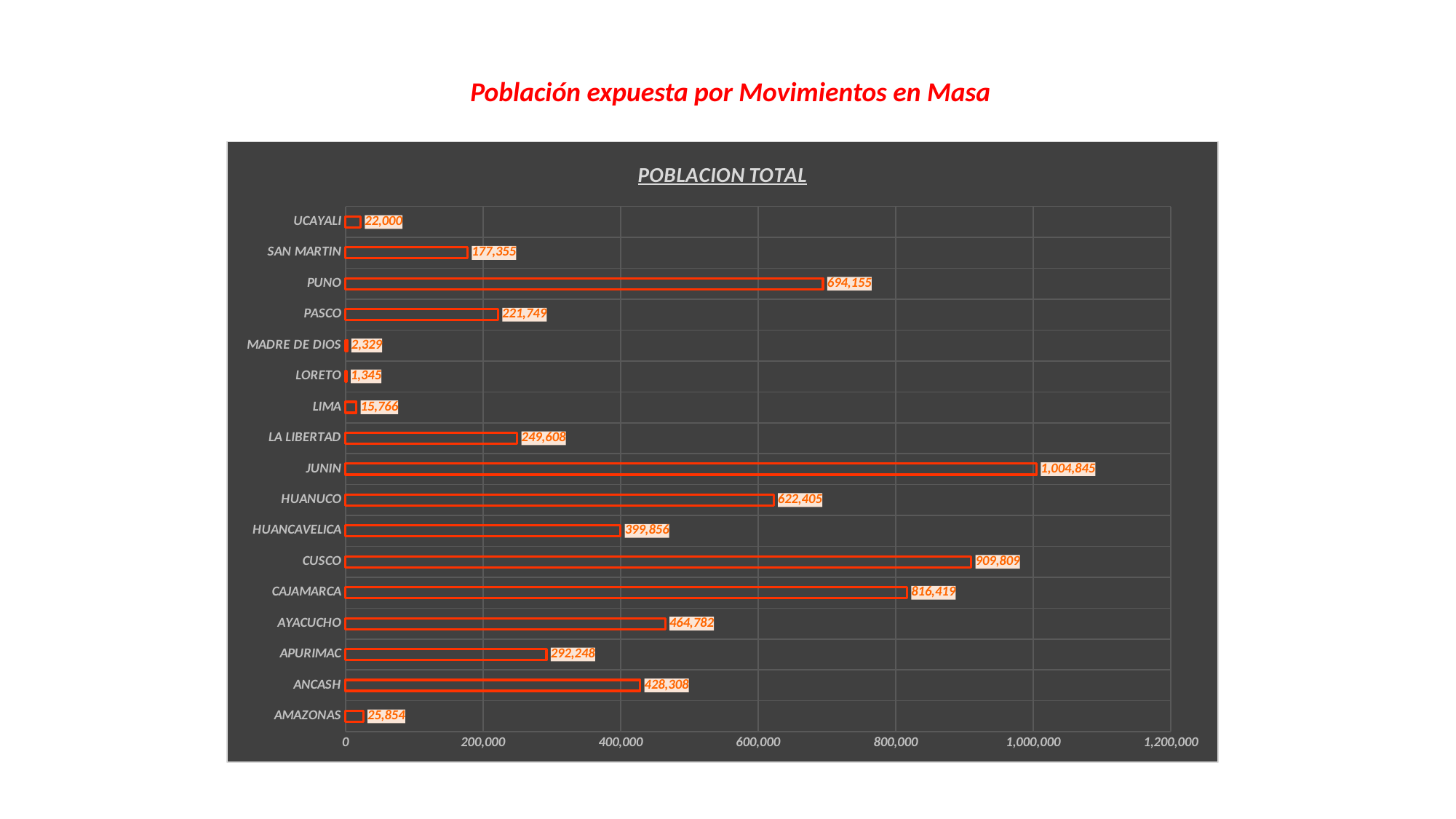
What is the value for APURIMAC? 292,248 What is the value for CAJAMARCA? 816,419 What is the difference between the values for CUSCO and CAJAMARCA? 93,390 Which is larger, the value for PUNO or the value for HUANUCO? PUNO What is the title of the chart? POBLACION TOTAL What is the value for JUNIN in the POBLACION TOTAL chart? 1,004,845 What is the value for MADRE DE DIOS? 2,329 Is the value for AYACUCHO greater or less than 400,000? greater What kind of chart is shown on the slide? bar chart How many categories are shown in the chart? 17 Which category has the lowest value? LORETO Which category has the highest value? JUNIN